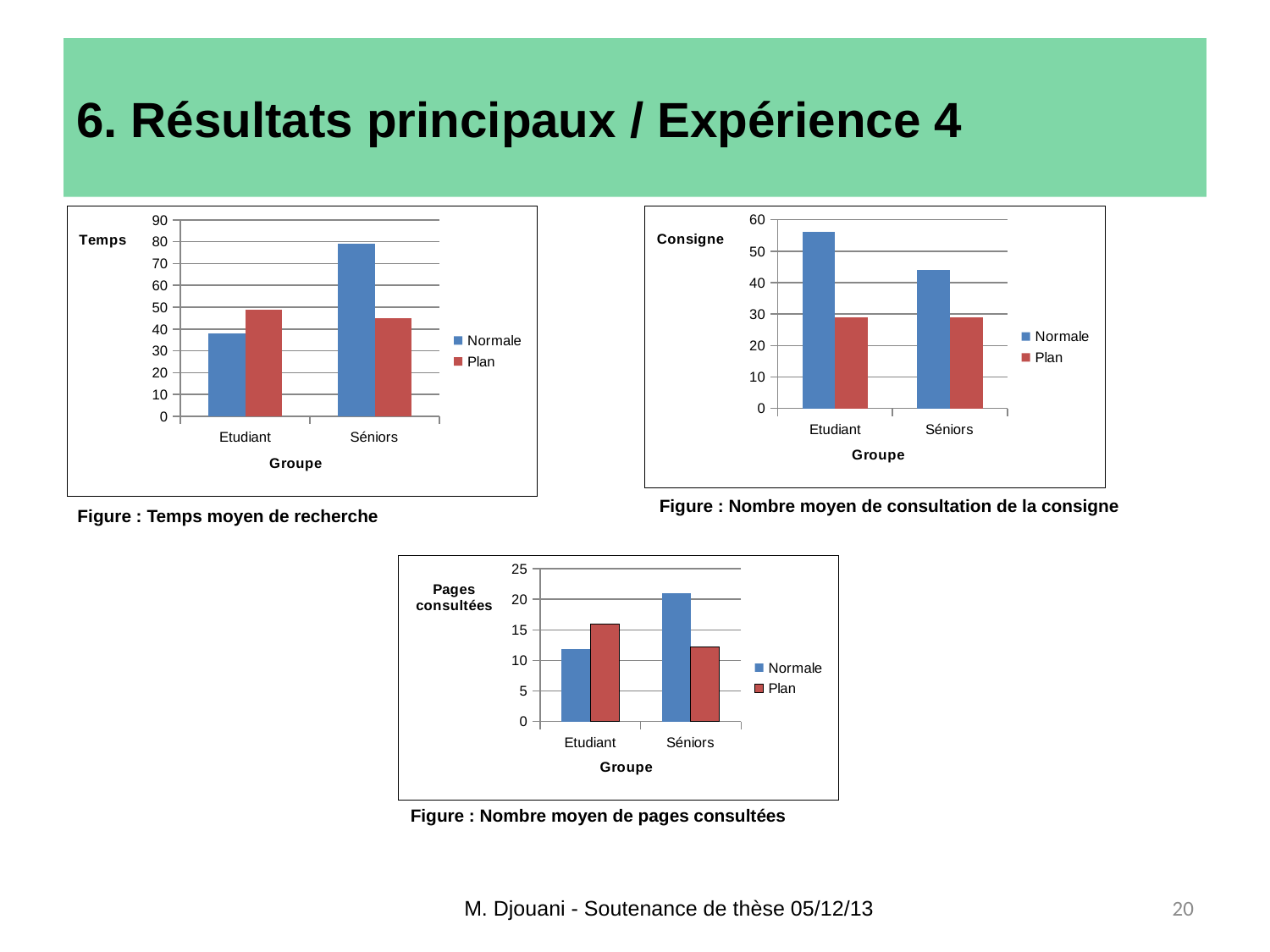
In the chart titled 'Nombre moyen de pages consultées', how many series does the legend list? 2 In the chart titled 'Temps moyen de recherche', which group has the highest Normale bar? Séniors In the chart titled 'Nombre moyen de pages consultées', is the Normale value for Séniors greater or less than 20? greater What kind of chart is the chart titled 'Nombre moyen de consultation de la consigne'? bar chart In the chart titled 'Nombre moyen de pages consultées', for Etudiant, which series is larger, Normale or Plan? Plan How many groups are shown on the x axis of the chart titled 'Temps moyen de recherche'? 2 In the chart titled 'Nombre moyen de consultation de la consigne', is the Normale value for Etudiant greater or less than 50? greater In the chart titled 'Temps moyen de recherche', is the Normale value for Etudiant greater or less than 40? less In the chart titled 'Temps moyen de recherche', for Etudiant, which series is larger, Normale or Plan? Plan In the chart titled 'Nombre moyen de consultation de la consigne', for Séniors, which series is larger, Normale or Plan? Normale